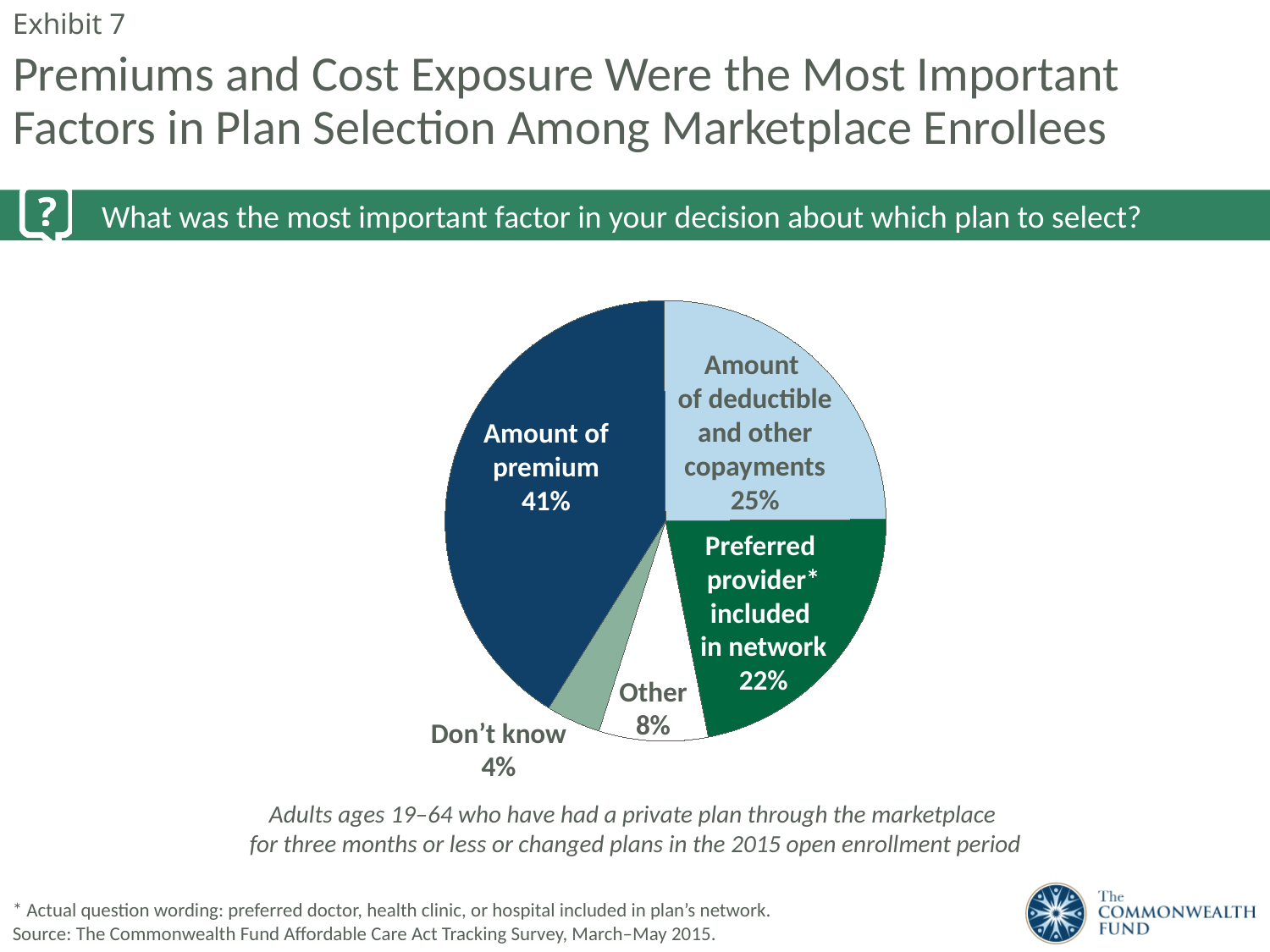
What survey question is shown in the green banner above the chart? What was the most important factor in your decision about which plan to select? Which is larger: the share for 'Other' or the share for 'Don't know'? Other What is the value for the 'Preferred provider included in network' slice? 22% What is the combined share of 'Amount of premium' and 'Amount of deductible and other copayments'? 66% What percentage of respondents answered 'Don't know'? 4% What share of respondents said the amount of premium was the most important factor? 41% What kind of chart is shown on the slide? pie chart Which factor has the largest share of the pie? Amount of premium How many percentage points larger is the 'Amount of premium' slice than the 'Amount of deductible and other copayments' slice? 16 Which slice of the pie is the smallest? Don't know How many slices does the pie chart have? 5 What percentage chose amount of deductible and other copayments as the most important factor? 25%